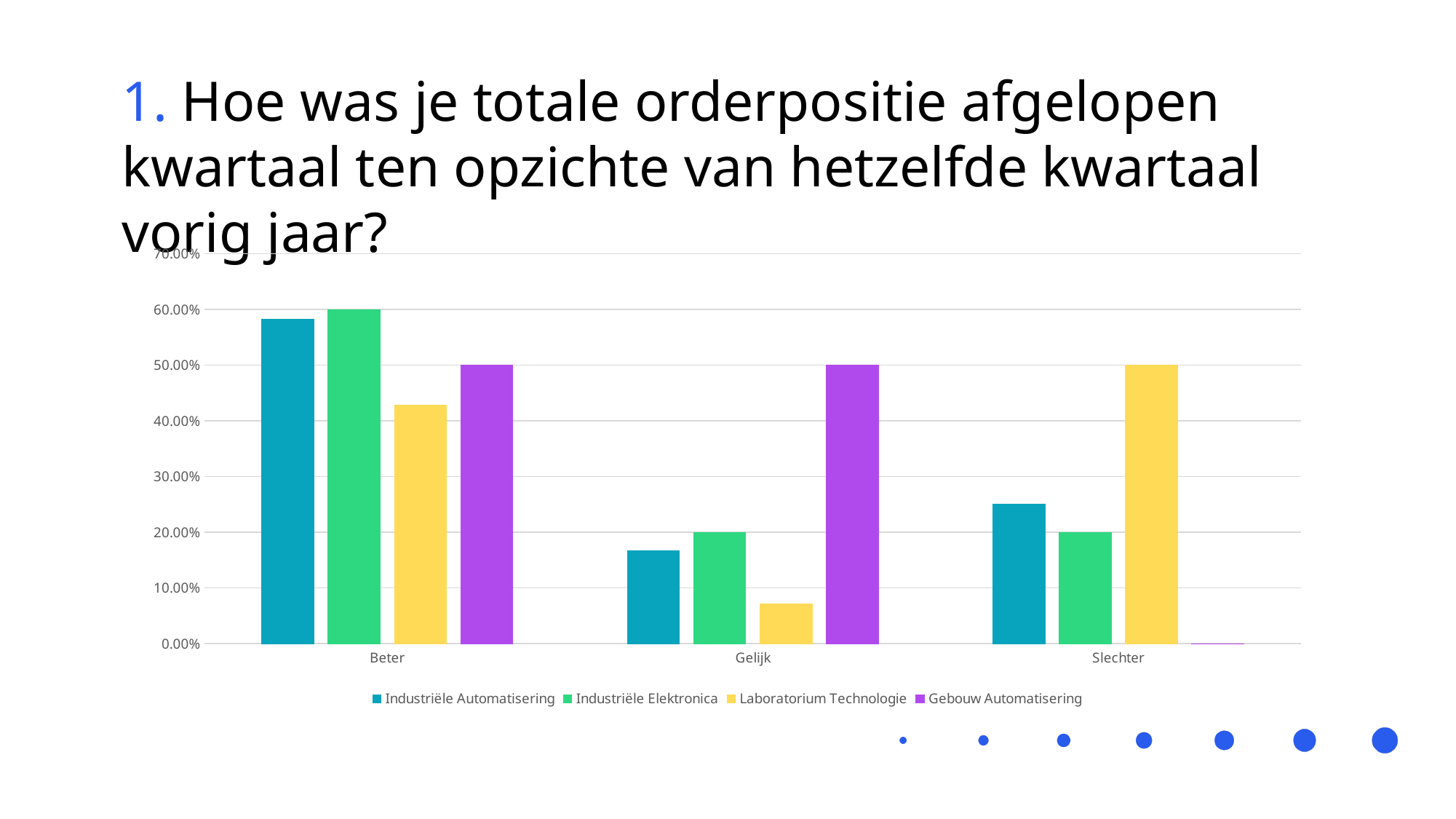
Is the value for Industriële Automatisering in the Beter category greater or less than 50.00%? greater How many categories are shown on the x axis of the chart? 3 How many series does the chart legend list? 4 What colour are the bars for Laboratorium Technologie? yellow Is the value for Industriële Automatisering in the Slechter category greater or less than 20.00%? greater Which series has the lowest value in the Slechter category? Gebouw Automatisering Which is larger: Gebouw Automatisering in the Gelijk category or Industriële Automatisering in the Gelijk category? Gebouw Automatisering Which series has the highest value in the Beter category? Industriële Elektronica What kind of chart is shown on the slide? bar chart Which is larger: Laboratorium Technologie in the Beter category or Laboratorium Technologie in the Slechter category? Slechter Which series has the lowest value in the Gelijk category? Laboratorium Technologie Is the value for Laboratorium Technologie in the Gelijk category greater or less than 10.00%? less